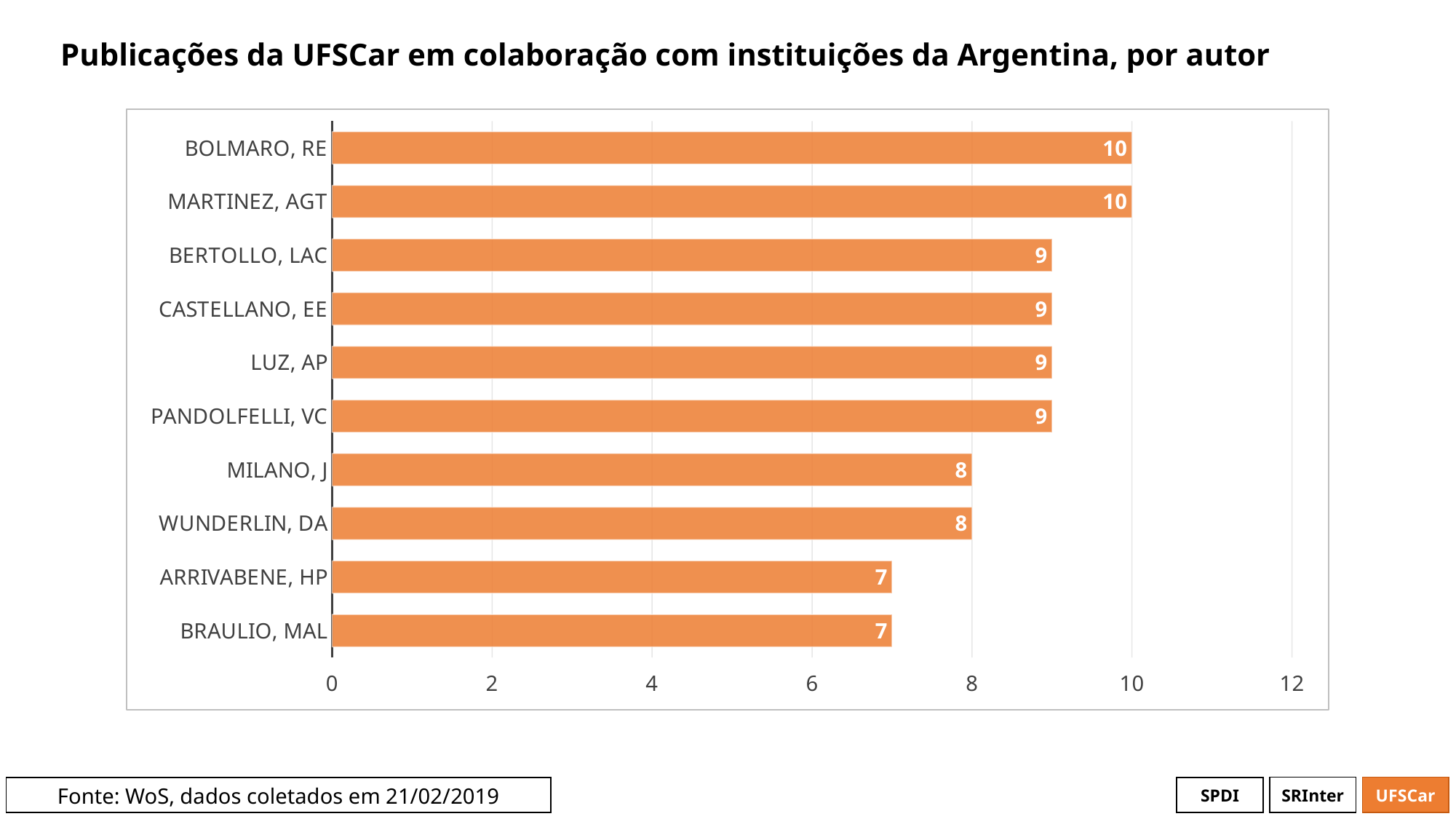
How many authors are shown on the chart? 10 What is the value for BRAULIO, MAL? 7 What is the value for MILANO, J? 8 What kind of chart is shown on the slide? bar chart What is the difference between the values for BOLMARO, RE and ARRIVABENE, HP? 3 What is the title of the chart? Publicações da UFSCar em colaboração com instituições da Argentina, por autor Is the value for LUZ, AP greater or less than 6? greater Which authors have the lowest value on the chart? ARRIVABENE, HP and BRAULIO, MAL What is the value for MARTINEZ, AGT? 10 Which authors have the highest value on the chart? BOLMARO, RE and MARTINEZ, AGT Which is larger, the value for CASTELLANO, EE or the value for WUNDERLIN, DA? CASTELLANO, EE What is the value for BERTOLLO, LAC? 9